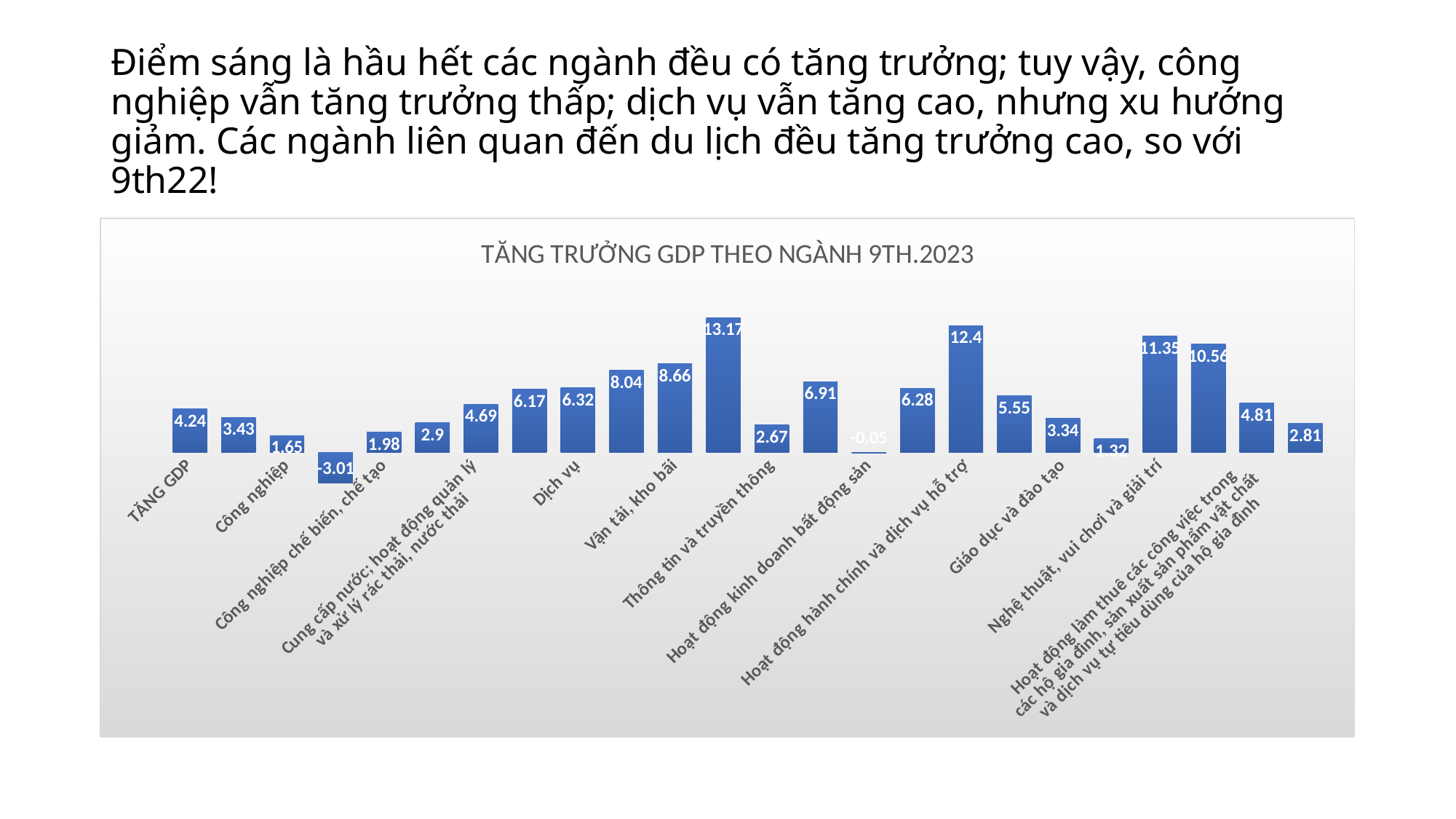
What is the lowest value shown on the chart? -3.01 What is the difference between the values for Dịch vụ and Công nghiệp? 4.67 What is the highest value shown on the chart? 13.17 What is the value for Nghệ thuật, vui chơi và giải trí? 11.35 What is the value for Công nghiệp? 1.65 What is the value for Hoạt động kinh doanh bất động sản? -0.05 What is the value for TĂNG GDP? 4.24 What is the value for Hoạt động hành chính và dịch vụ hỗ trợ? 12.4 Which is larger, the value for Hoạt động hành chính và dịch vụ hỗ trợ or the value for Nghệ thuật, vui chơi và giải trí? Hoạt động hành chính và dịch vụ hỗ trợ What is the value for Dịch vụ? 6.32 What is the title of the chart? TĂNG TRƯỞNG GDP THEO NGÀNH 9TH.2023 How many bars are plotted on the chart? 24